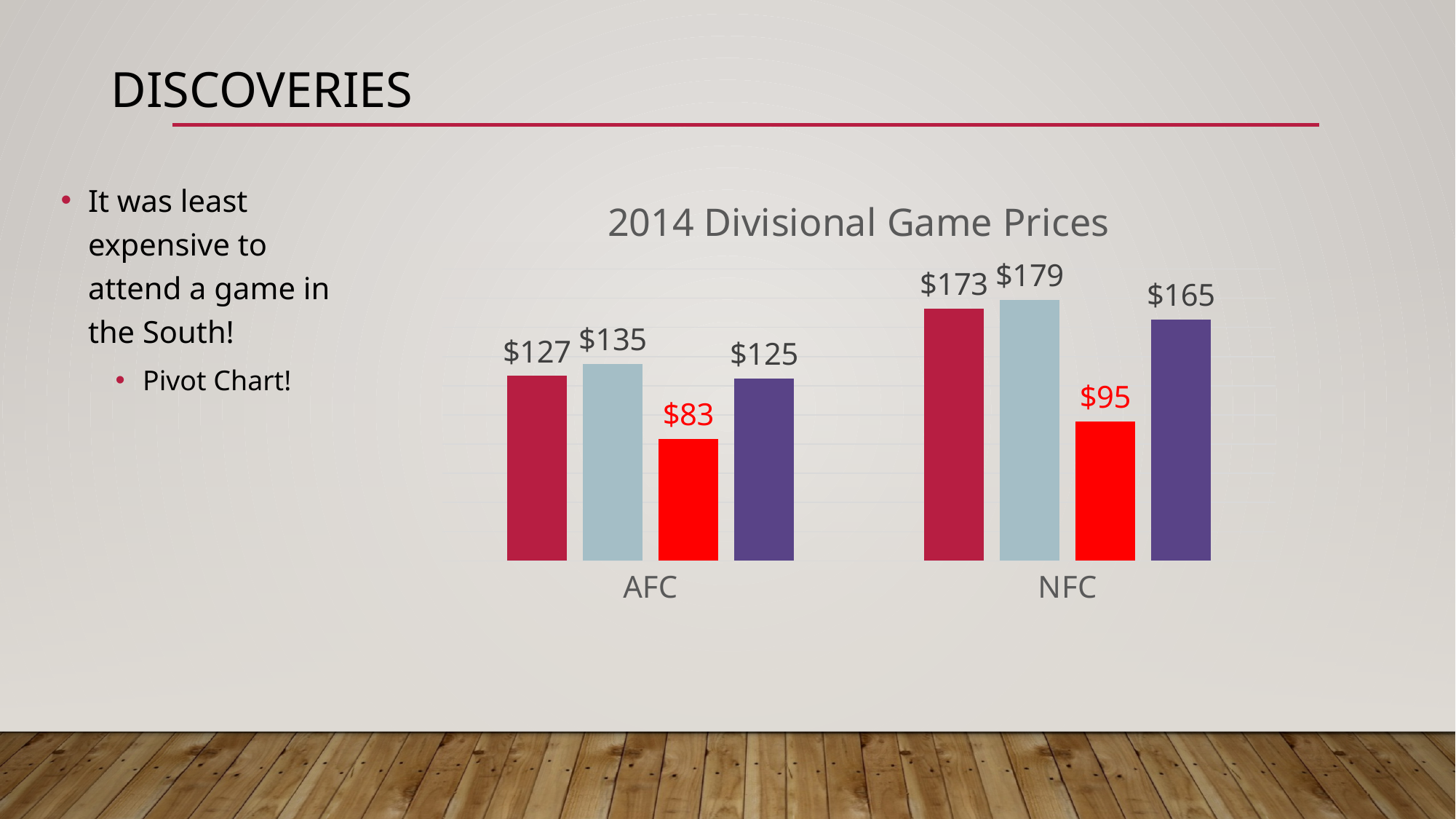
What is the value of the purple bar in the NFC group? $165 What is the difference between the bright red bar in the NFC group and the bright red bar in the AFC group? $12 Which is larger in the NFC group: the crimson bar or the purple bar? the crimson bar ($173) What is the value of the leftmost (crimson) bar in the AFC group? $127 How many categories are shown on the x axis of the chart? 2 What is the lowest value shown in the AFC group? $83 What is the highest value shown in the NFC group? $179 What kind of chart is shown on the slide? bar chart What is the value of the bright red bar in the NFC group? $95 What is the title of the chart? 2014 Divisional Game Prices What is the difference between the light blue bar in the NFC group ($179) and the light blue bar in the AFC group ($135)? $44 How many bars are plotted in each category group of the chart? 4